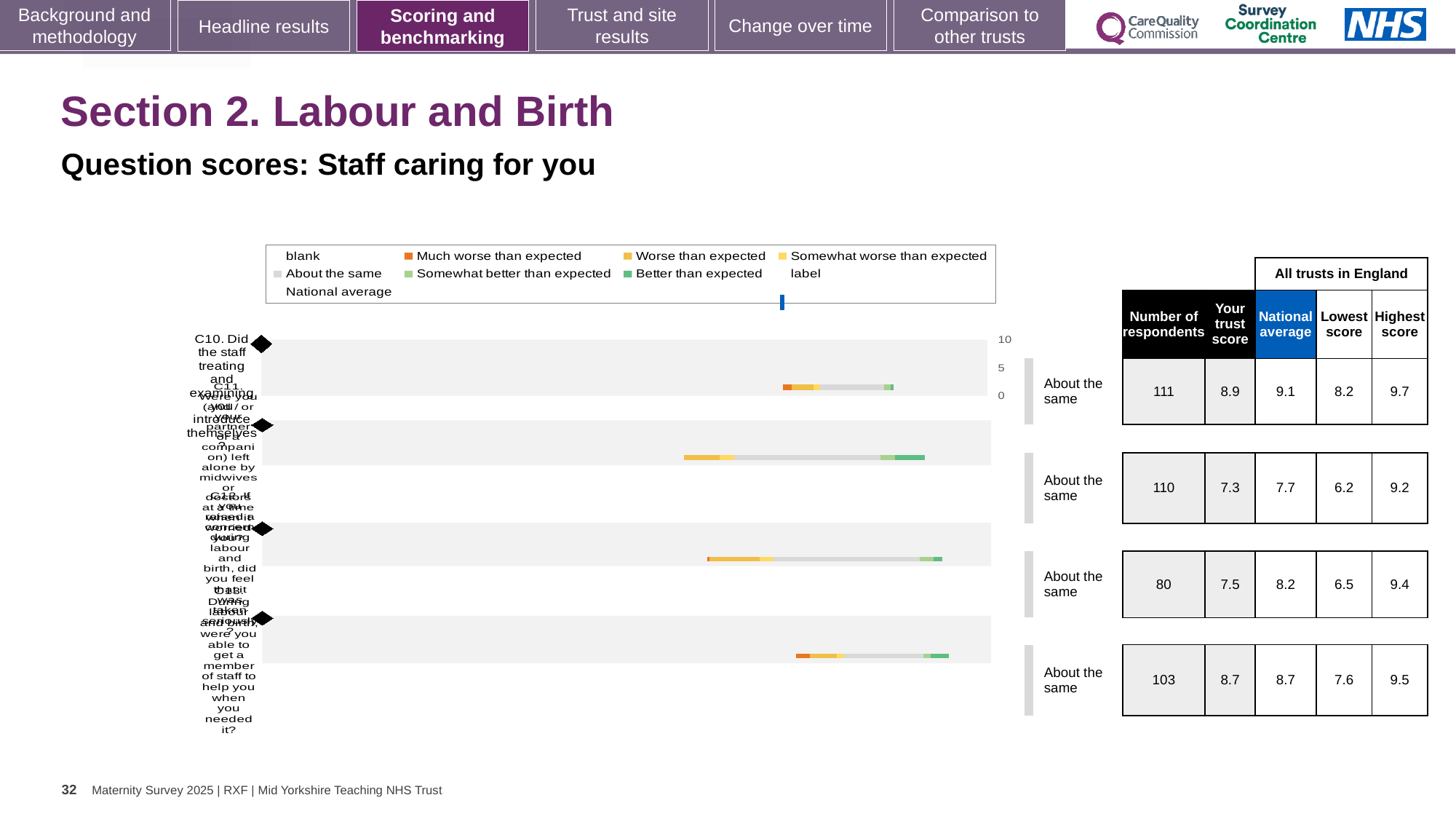
How many question rows are shown in the chart and table? 4 What benchmark category is shown next to each of the four question rows? About the same In the table, what is the number of respondents for the first question row (C10)? 111 What kind of chart is shown on the slide? bar chart Which question row has the lowest 'Lowest score' value in the table? the second row, with 6.2 In the table, what is the lowest score for the fourth question row? 7.6 In the table, what is the highest score for the third question row? 9.4 In the first question row, is the trust score higher or lower than the national average? lower In the table, what is the national average for the second question row? 7.7 What is the difference between the national average and the trust score in the second question row? 0.4 In the table, what is the 'Your trust score' for the first question row (C10)? 8.9 Which question row has the most respondents in the table? the first row (C10), with 111